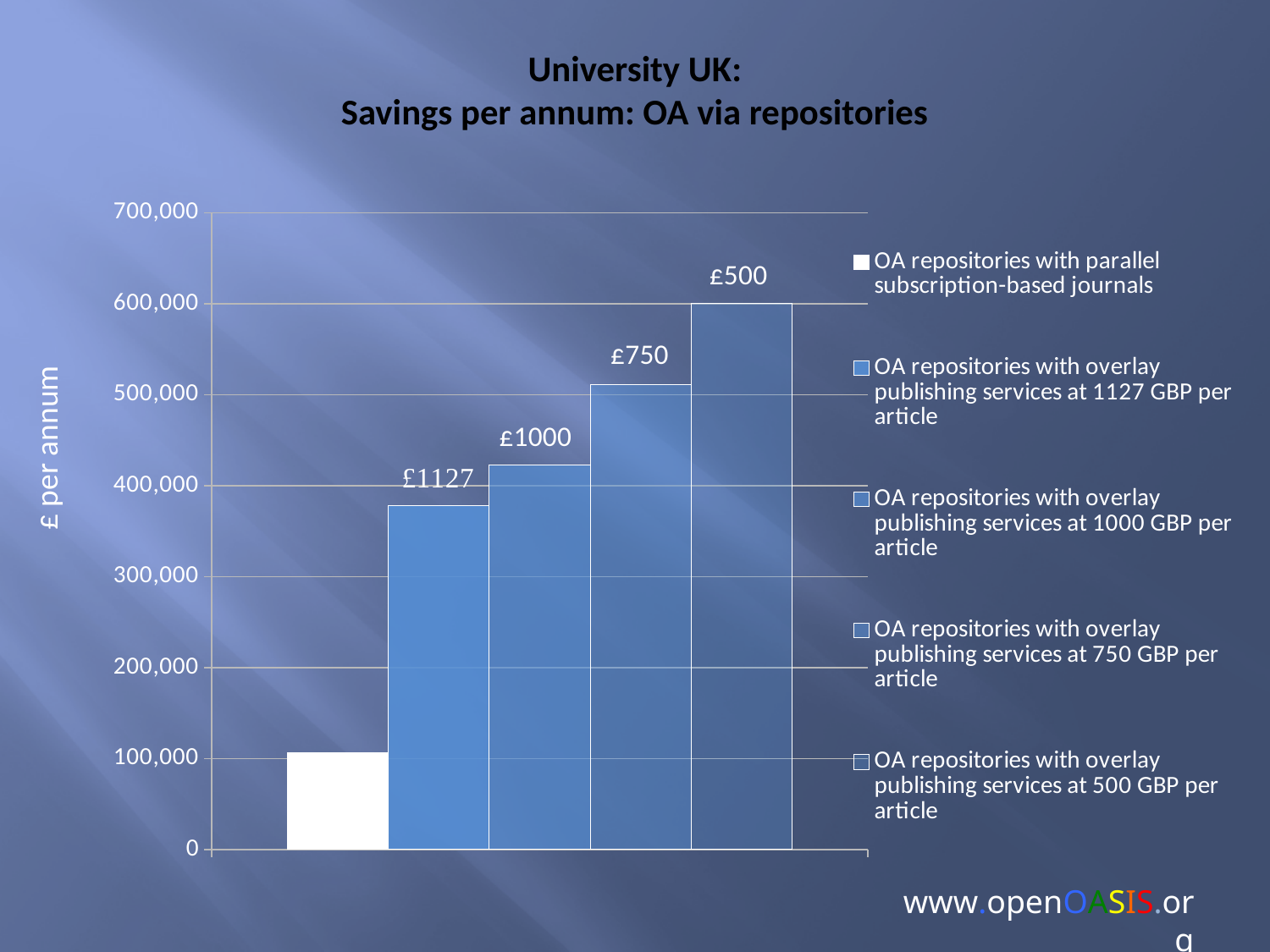
How many series does the legend list? 5 Is the value for OA repositories with overlay publishing services at 750 GBP per article greater or less than 500,000? greater What kind of chart is shown on the slide? bar chart What is the label on the vertical axis of the chart? £ per annum Is the value for OA repositories with overlay publishing services at 1000 GBP per article greater or less than 500,000? less Which is larger: the savings for overlay publishing services at 750 GBP per article or at 1000 GBP per article? 750 GBP per article Is the value for OA repositories with overlay publishing services at 1127 GBP per article greater or less than 300,000? greater Do the bars rise or fall from left to right across the chart? rise Which series has the lowest savings per annum? OA repositories with parallel subscription-based journals How many bars are plotted in the chart? 5 Which series has the highest savings per annum? OA repositories with overlay publishing services at 500 GBP per article